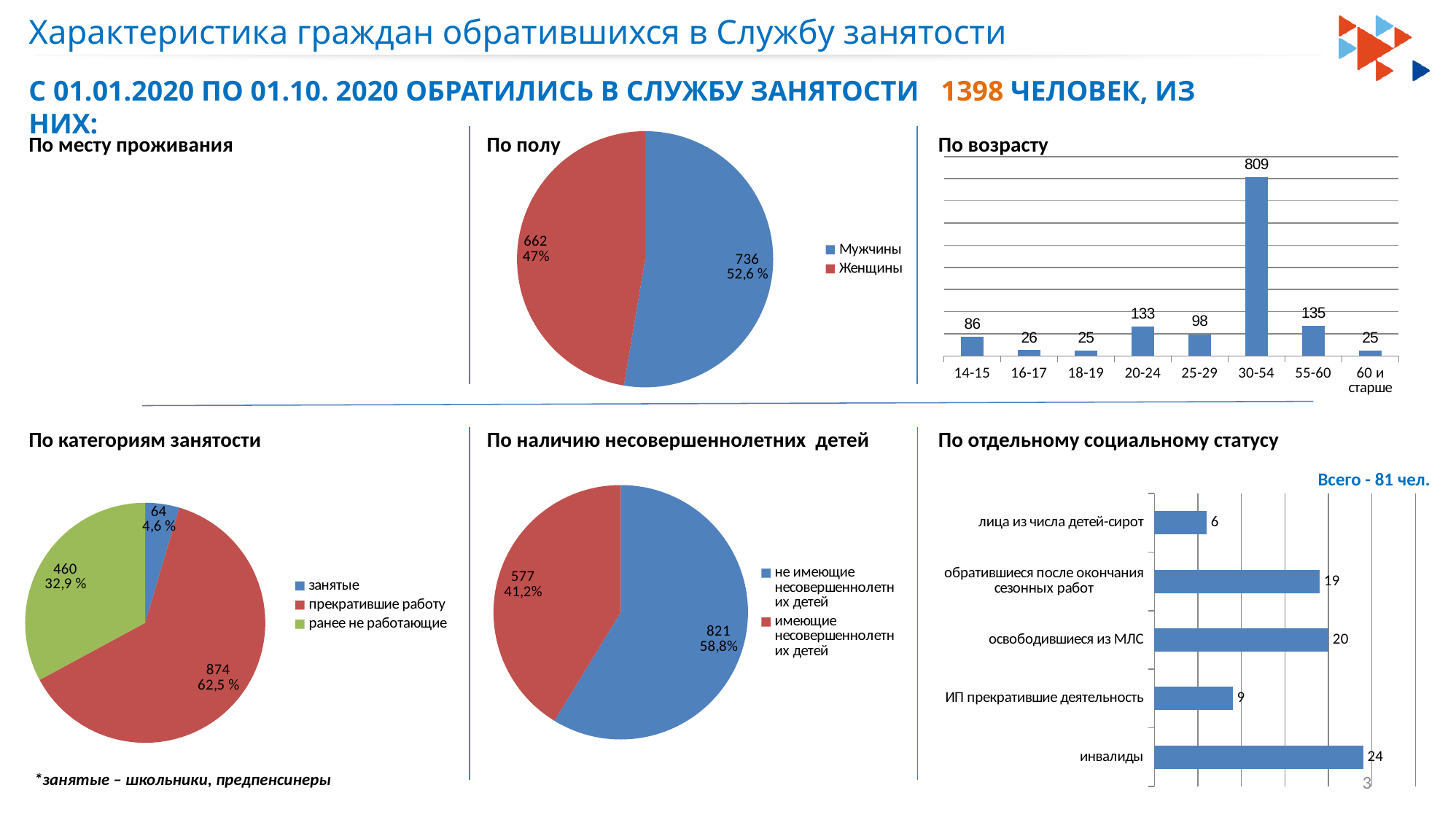
In the "По отдельному социальному статусу" chart, which category has the highest value? инвалиды In the "По полу" pie chart, what share of the pie is Мужчины? 52,6 % In the "По возрасту" chart, what is the value for the 30-54 age group? 809 In the "По категориям занятости" pie chart, what is the value for ранее не работающие? 460 In the "По возрасту" chart, how many age groups are shown? 8 In the "По отдельному социальному статусу" chart, what is the value for освободившиеся из МЛС? 20 In the "По возрасту" chart, which age group has the lowest value? 18-19 and 60 и старше (25 each) In the "По полу" pie chart, what is the value for Женщины? 662 In the "По наличию несовершеннолетних детей" pie chart, what share is имеющие несовершеннолетних детей? 41,2% What kind of chart is the "По отдельному социальному статусу" chart? bar chart In the "По возрасту" chart, what is the difference between the values for 20-24 and 25-29? 35 In the "По категориям занятости" pie chart, which category is the largest? прекратившие работу